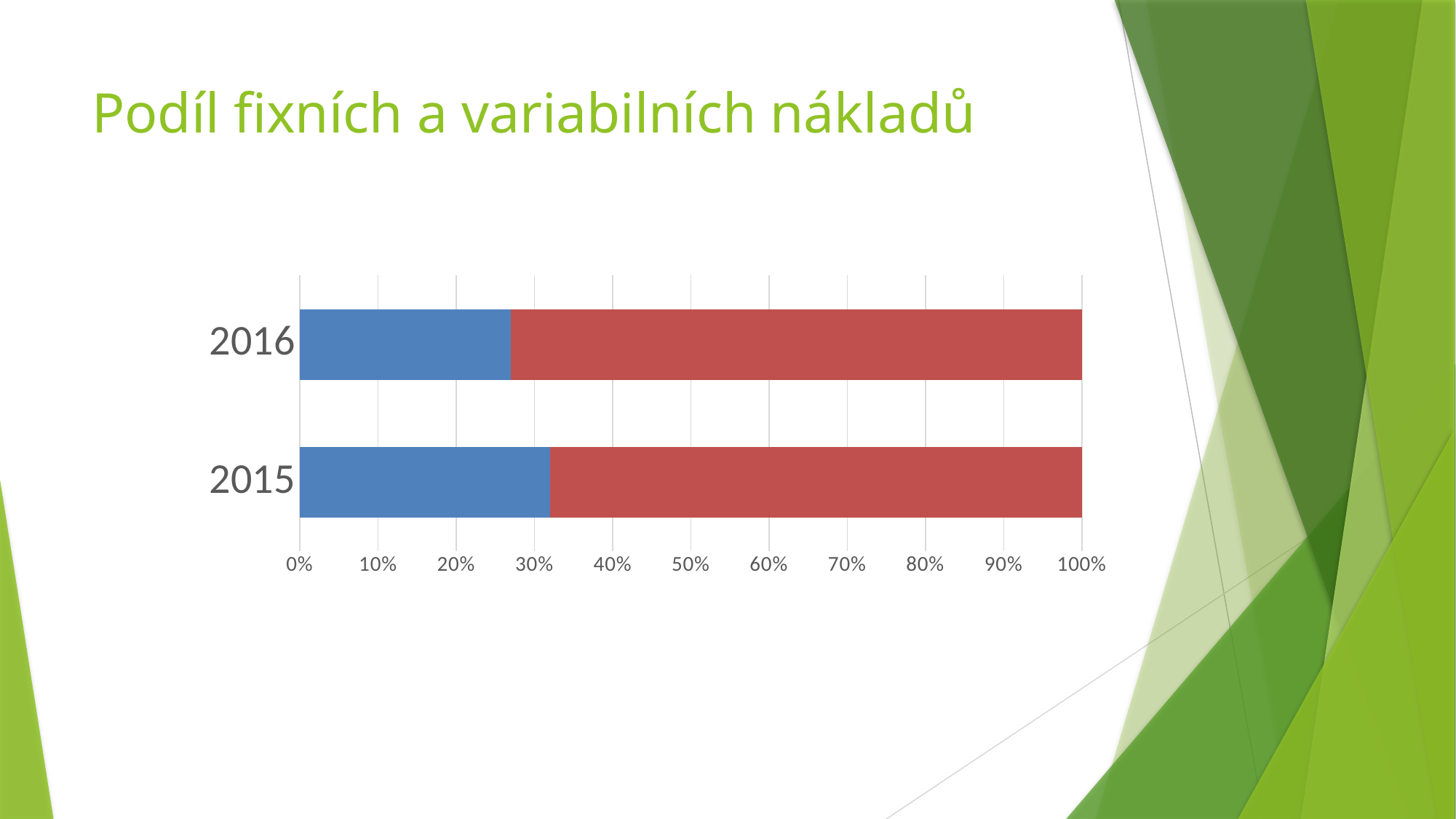
Which year is listed at the top of the chart? 2016 Which year has the larger blue segment, 2015 or 2016? 2015 Is the blue segment for 2016 greater or less than 30%? less Is the blue segment for 2015 greater or less than 30%? greater What is the highest value shown on the x axis? 100% Is the blue segment for 2016 greater or less than 20%? greater What is the title of the slide containing the chart? Podíl fixních a variabilních nákladů How many categories (years) are shown on the chart? 2 What value does each full stacked bar reach on the x axis? 100% What kind of chart is shown on the slide? bar chart Which year has the larger red segment, 2015 or 2016? 2016